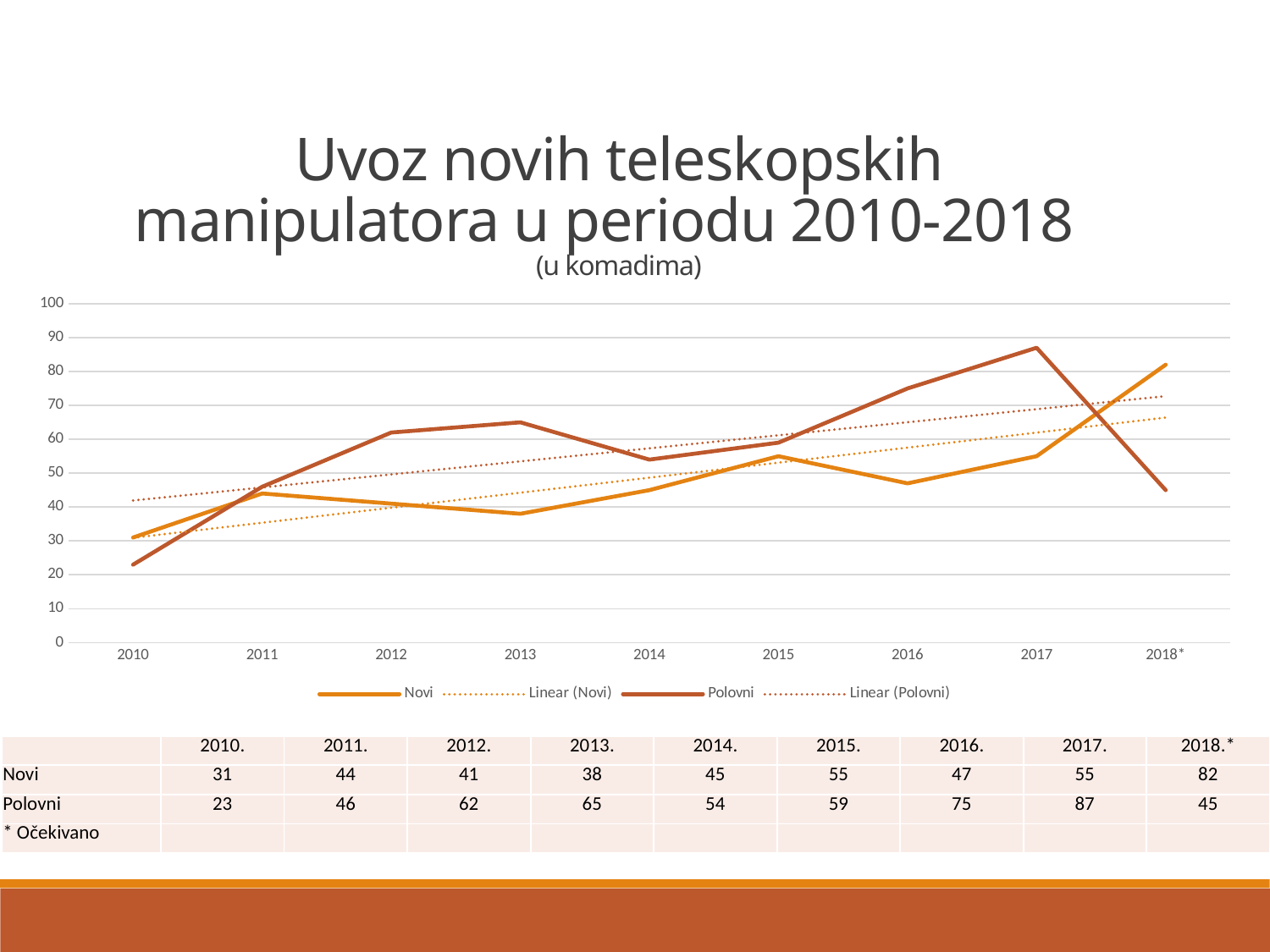
In which year does the Polovni series reach its highest value? 2017 What kind of chart is shown on the slide? line chart Which series has the larger value in 2018*, Novi or Polovni? Novi Is the value for Polovni in 2016 greater or less than 70? greater Does the Polovni series rise or fall from 2017 to 2018*? fall How many years are shown on the x axis? 9 What is the value for Novi in 2015? 55 In which year is the Novi series at its lowest? 2010 What is the difference between Polovni and Novi in 2017? 32 How many entries does the legend list? 4 What is the value for Polovni in 2013? 65 What unit is given in the subtitle under the chart title? u komadima